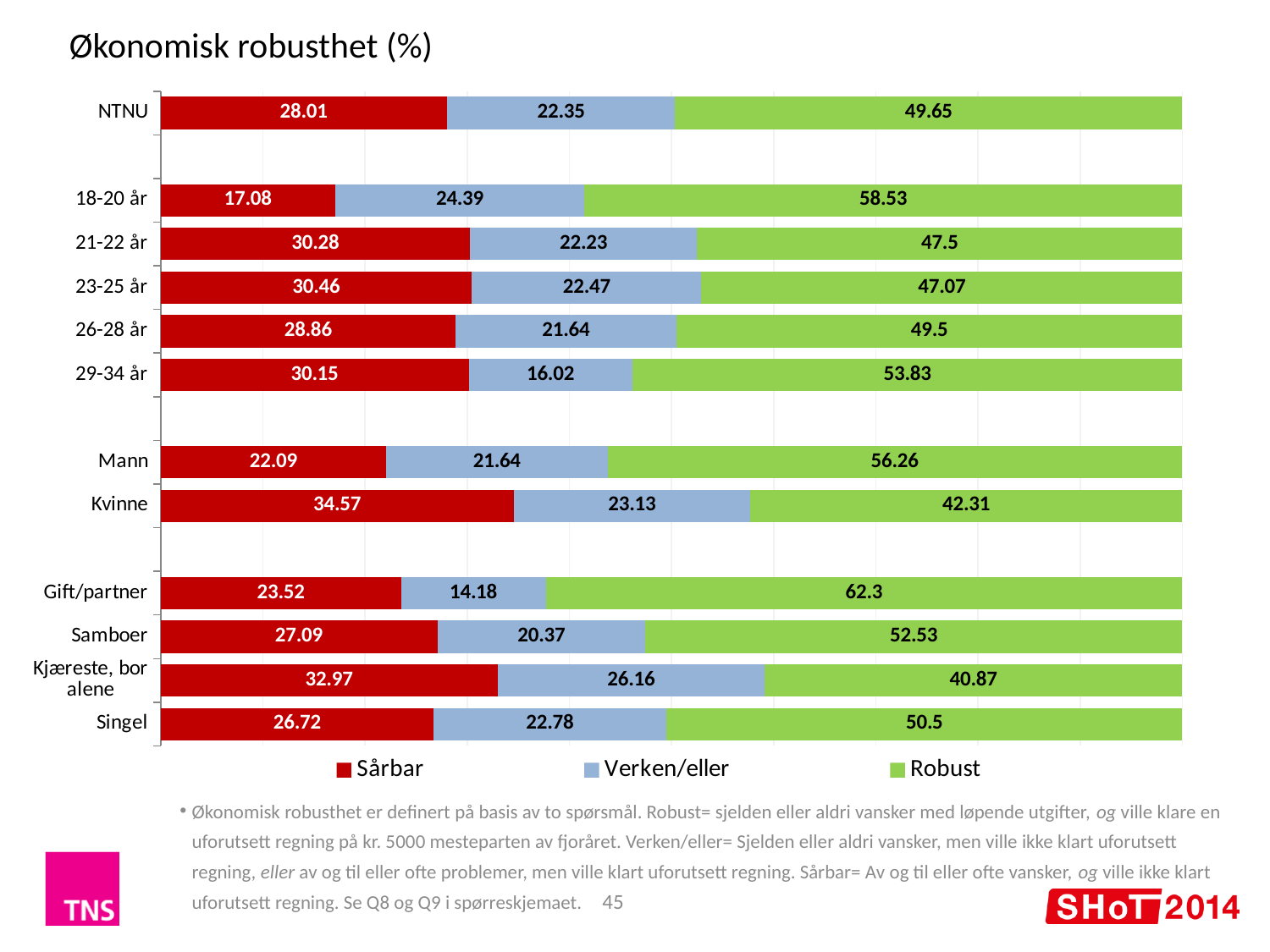
Which category has the lowest Sårbar value? 18-20 år Which has a larger Robust value, 18-20 år or 29-34 år? 18-20 år Which category has the lowest Verken/eller value? Gift/partner What is the Verken/eller value for 29-34 år? 16.02 What is the Robust value for Gift/partner? 62.3 How many series does the legend list? 3 Which category has the highest Robust value? Gift/partner What is the difference between the Robust values for Mann and Kvinne? 13.95 What kind of chart is shown on the slide? Stacked bar chart Which category has the highest Sårbar value? Kvinne What is the Sårbar value for Kvinne? 34.57 How many categories are shown on the chart? 12